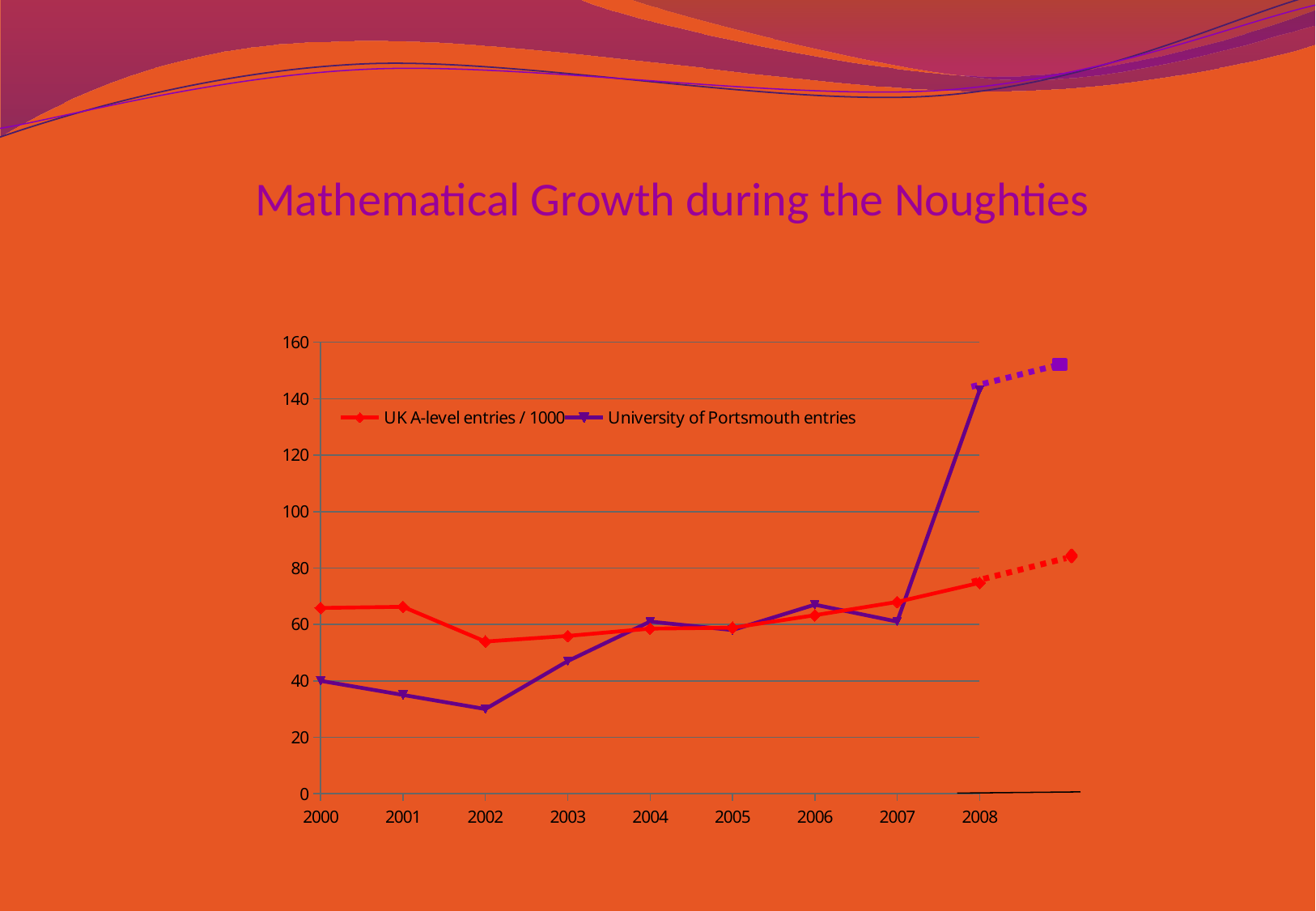
Is the University of Portsmouth entries value for 2008 greater or less than 140? greater In 2008, which series has the larger value: UK A-level entries / 1000 or University of Portsmouth entries? University of Portsmouth entries In which year is the University of Portsmouth entries value highest? 2008 What is the title of the slide's chart? Mathematical Growth during the Noughties Does the University of Portsmouth entries series rise or fall between 2007 and 2008? rise How many years are labelled on the x axis? 9 In which year is the UK A-level entries / 1000 value highest? 2008 How many series does the legend list? 2 In which year is the University of Portsmouth entries value lowest? 2002 Is the UK A-level entries / 1000 value for 2002 greater or less than 60? less Which series is drawn in purple? University of Portsmouth entries What kind of chart is shown on the slide? line chart